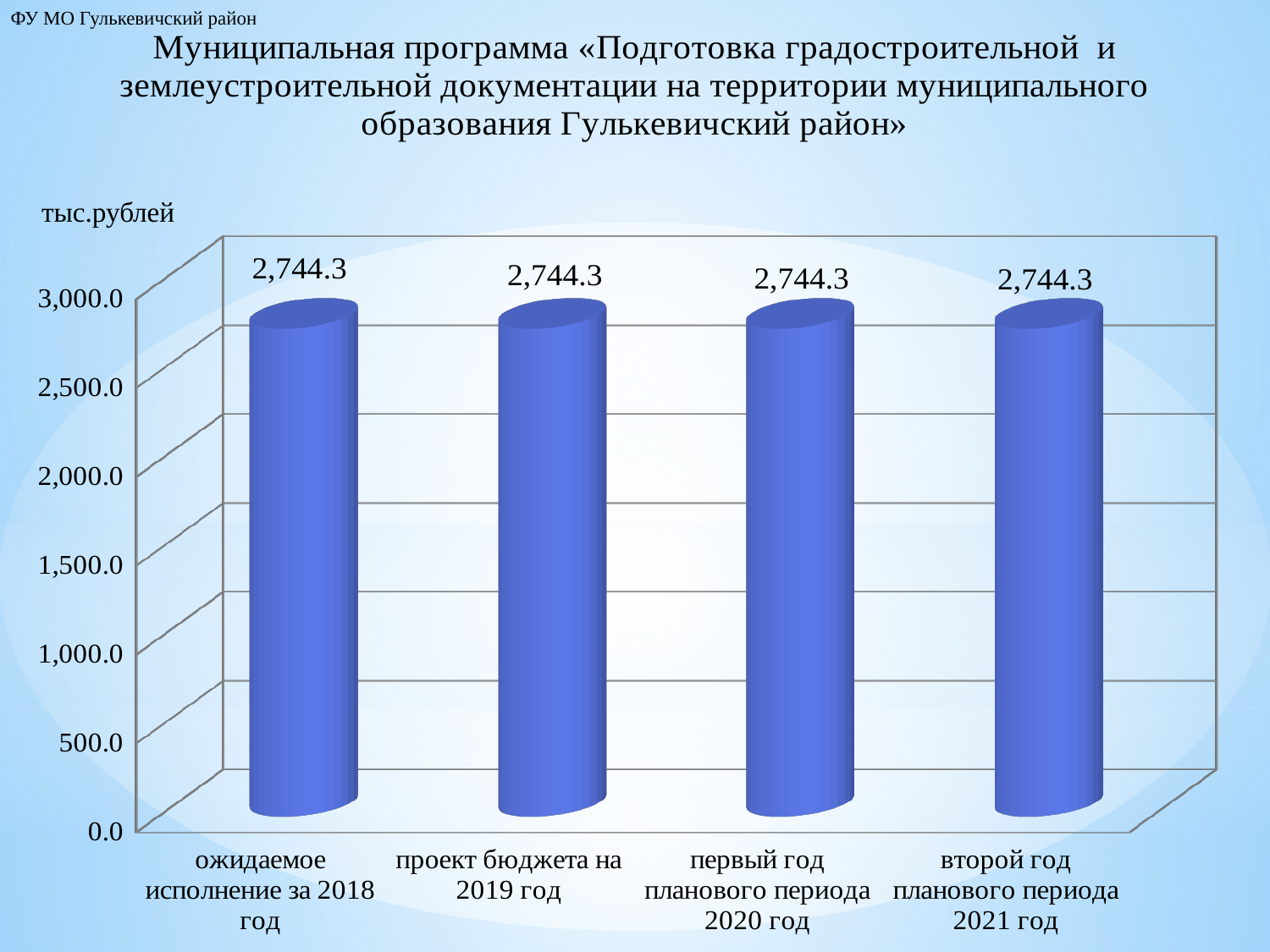
How many categories are shown on the x axis of the chart? 4 What is the difference between the value for 2019 год and the value for 2021 год? 0.0 Which is larger, the value for "ожидаемое исполнение за 2018 год" or the value for "проект бюджета на 2019 год"? They are equal What kind of chart is shown on the slide? Bar chart Do the values rise, fall, or stay the same from 2018 to 2021 along the x axis? Stay the same What is the value for "ожидаемое исполнение за 2018 год"? 2,744.3 What is the value for "второй год планового периода 2021 год"? 2,744.3 Is the value for "первый год планового периода 2020 год" greater or less than 2,500.0? greater What is the highest tick value shown on the vertical axis? 3,000.0 What unit is indicated above the vertical axis of the chart? тыс.рублей What is the value for "проект бюджета на 2019 год"? 2,744.3 What is the value for "первый год планового периода 2020 год"? 2,744.3